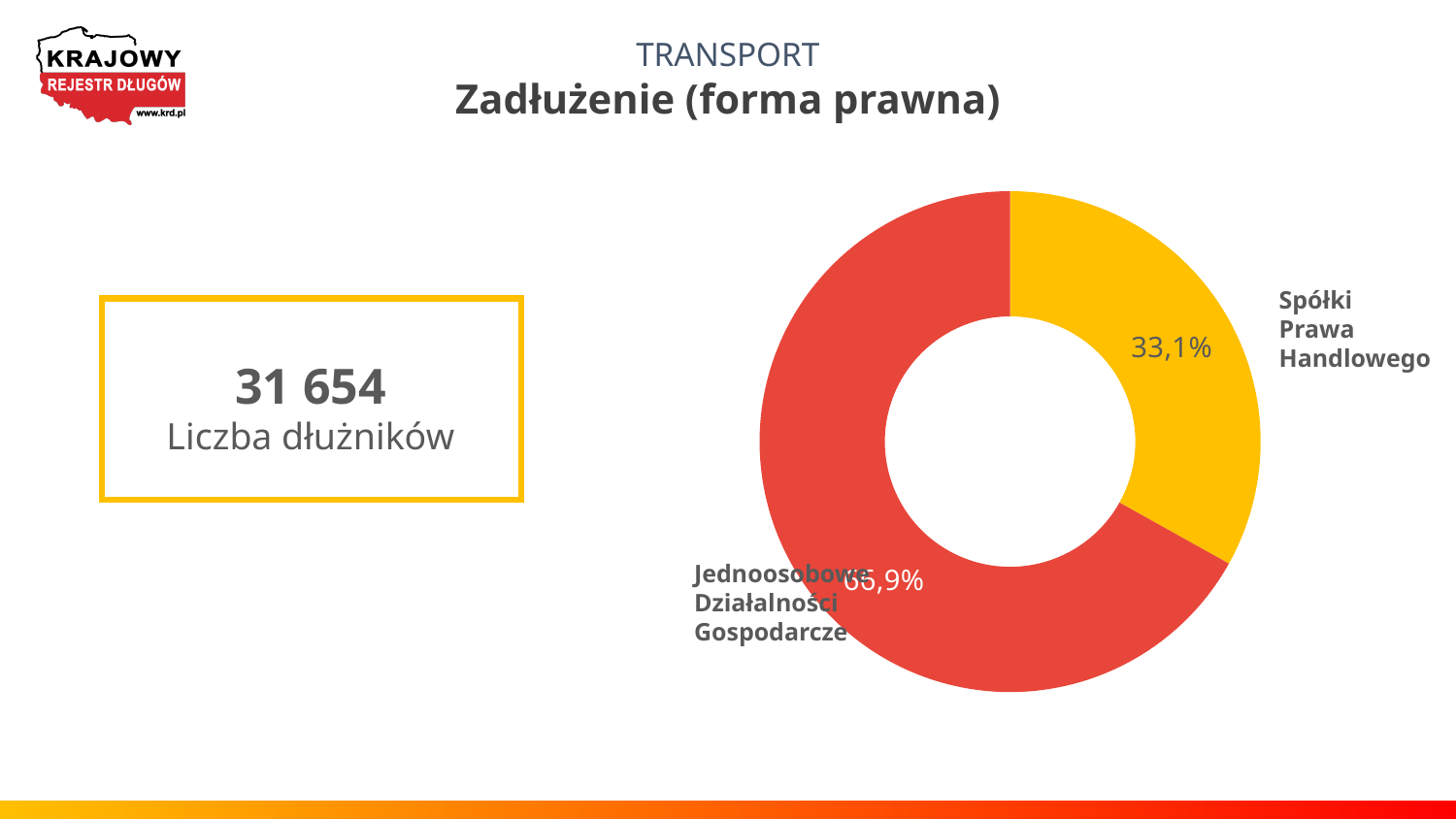
Which category has the largest share in the chart? Jednoosobowe Działalności Gospodarcze Which category has the smallest share in the chart? Spółki Prawa Handlowego What colour is the slice for Spółki Prawa Handlowego? Yellow How many categories are shown in the chart? 2 Which is larger: the share for Spółki Prawa Handlowego or the share for Jednoosobowe Działalności Gospodarcze? Jednoosobowe Działalności Gospodarcze What share of the pie chart is labelled for Spółki Prawa Handlowego? 33,1% What kind of chart is shown on the slide? Pie chart (donut) What share of the pie chart is labelled for Jednoosobowe Działalności Gospodarcze? 66,9% Is the share for Spółki Prawa Handlowego greater or less than 50%? less What is the difference in percentage points between the shares of Jednoosobowe Działalności Gospodarcze and Spółki Prawa Handlowego? 33,8 What is the title of the chart on the slide? Zadłużenie (forma prawna)